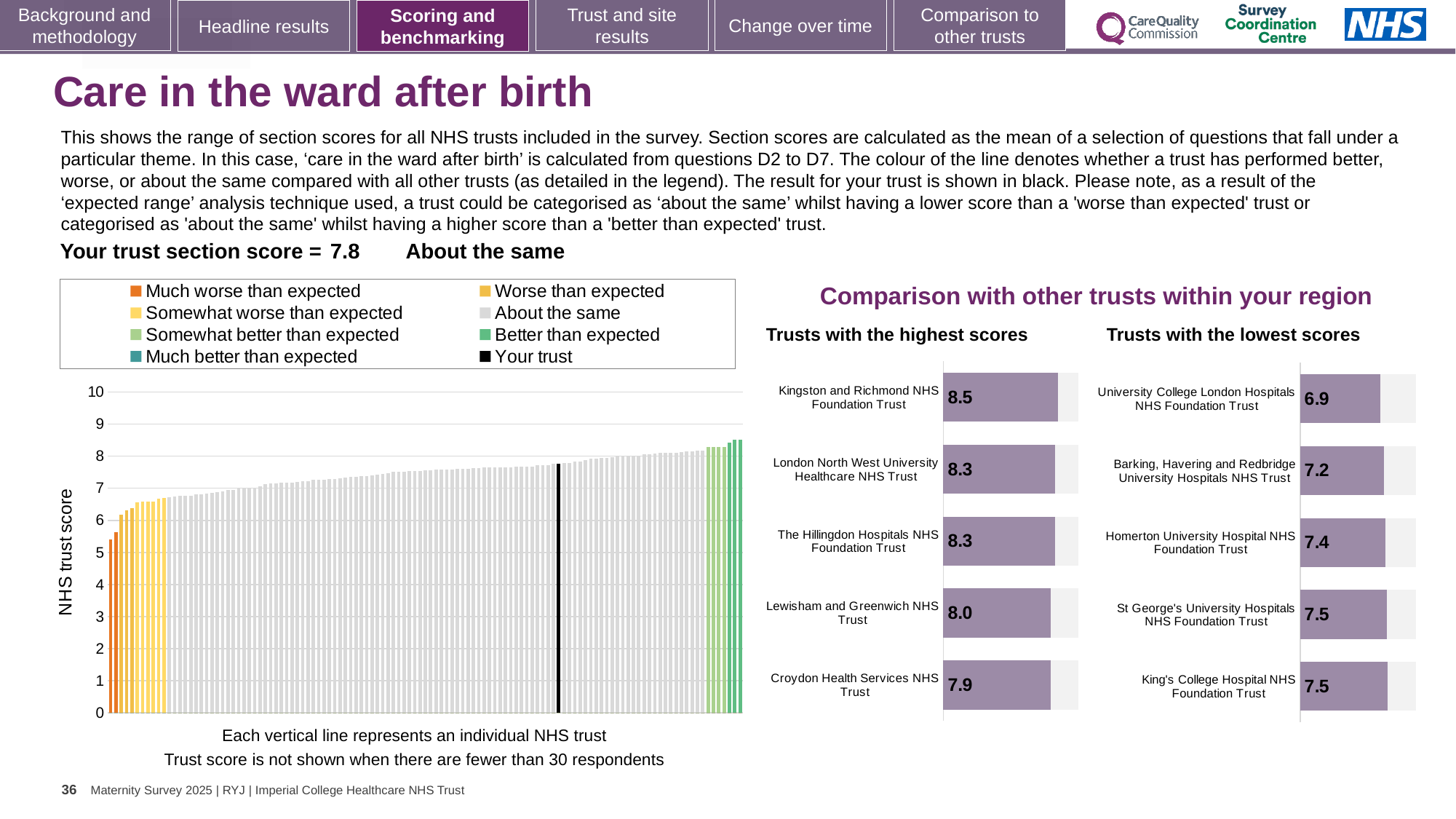
In the 'Trusts with the lowest scores' chart, what is the difference between the scores of Homerton University Hospital NHS Foundation Trust and University College London Hospitals NHS Foundation Trust? 0.5 In the large chart on the left, is the value for the lowest (leftmost) bar greater or less than 6? less In the 'Trusts with the lowest scores' chart, what is the score for University College London Hospitals NHS Foundation Trust? 6.9 How many entries does the legend above the large chart on the left list? 8 In the large chart on the left, is the value for the black 'Your trust' bar greater or less than 7? greater In the 'Trusts with the lowest scores' chart, which trust has the lowest score? University College London Hospitals NHS Foundation Trust In the 'Trusts with the highest scores' chart, what is the score for Kingston and Richmond NHS Foundation Trust? 8.5 In the 'Trusts with the highest scores' chart, how many trusts are shown? 5 In the 'Trusts with the highest scores' chart, which trust has the lowest score shown? Croydon Health Services NHS Trust In the 'Trusts with the highest scores' chart, what is the difference between the scores of Kingston and Richmond NHS Foundation Trust and Croydon Health Services NHS Trust? 0.6 What kind of chart is the large chart on the left showing NHS trust scores? Bar chart In the 'Trusts with the lowest scores' chart, which has the larger score: Barking, Havering and Redbridge University Hospitals NHS Trust or Homerton University Hospital NHS Foundation Trust? Homerton University Hospital NHS Foundation Trust